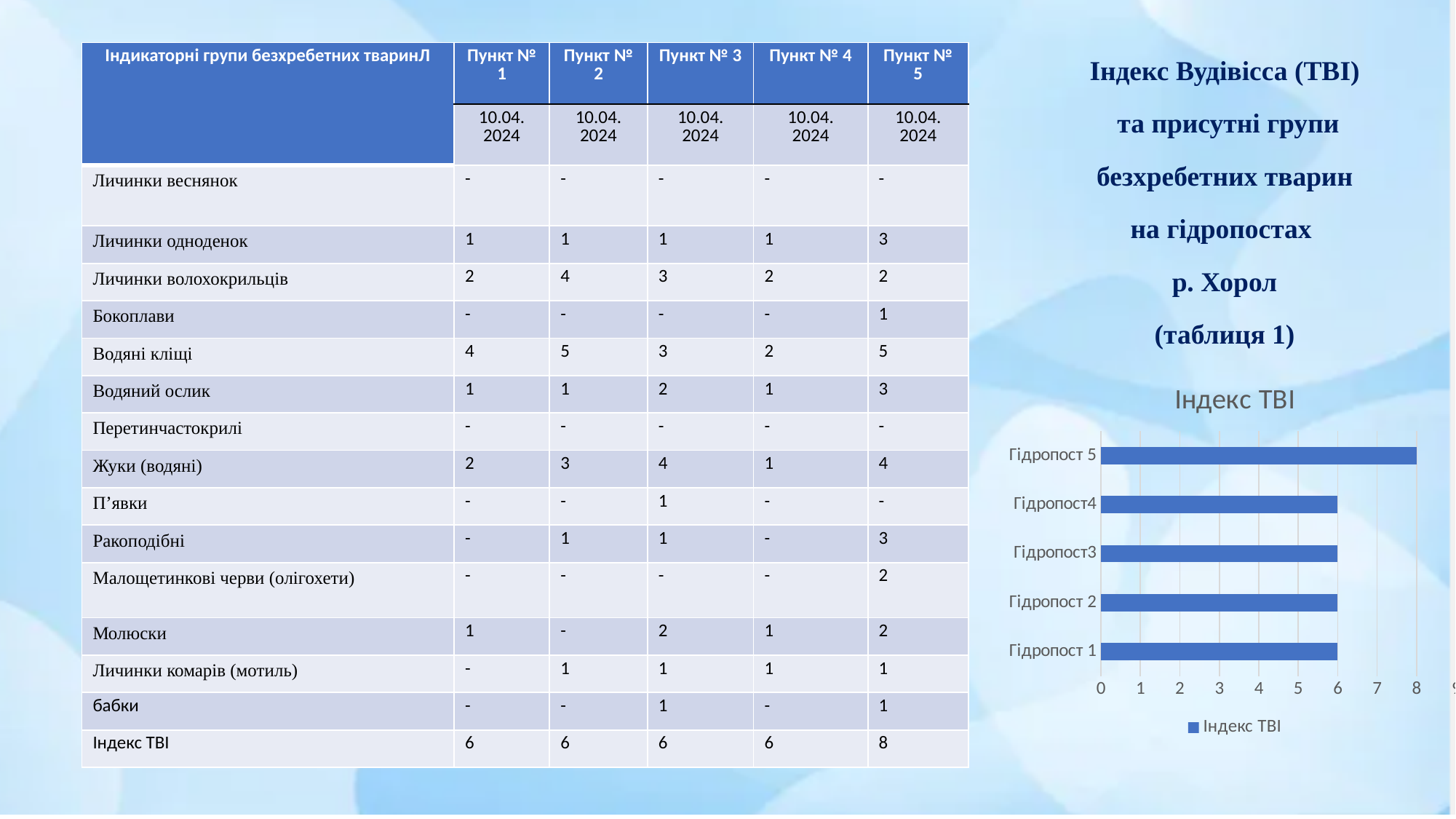
What type of chart is shown under the title "Індекс TBI"? bar chart In the "Індекс TBI" chart, which is larger: the value for Гідропост 5 or the value for Гідропост 4? Гідропост 5 In the "Індекс TBI" chart, what is the value for Гідропост 3? 6 In the "Індекс TBI" chart, what is the value for Гідропост 1? 6 In the "Індекс TBI" chart, what is the difference between the values for Гідропост 5 and Гідропост 2? 2 How many categories (hydroposts) are plotted in the "Індекс TBI" chart? 5 What is the legend entry shown below the "Індекс TBI" chart? Індекс TBI In the "Індекс TBI" chart, which hydropost has the highest value? Гідропост 5 In the "Індекс TBI" chart, is the value for Гідропост 2 greater or less than 7? less In the "Індекс TBI" chart, is the value for Гідропост 5 greater or less than 7? greater How many series does the legend of the "Індекс TBI" chart list? 1 In the "Індекс TBI" chart, what is the value for Гідропост 5? 8